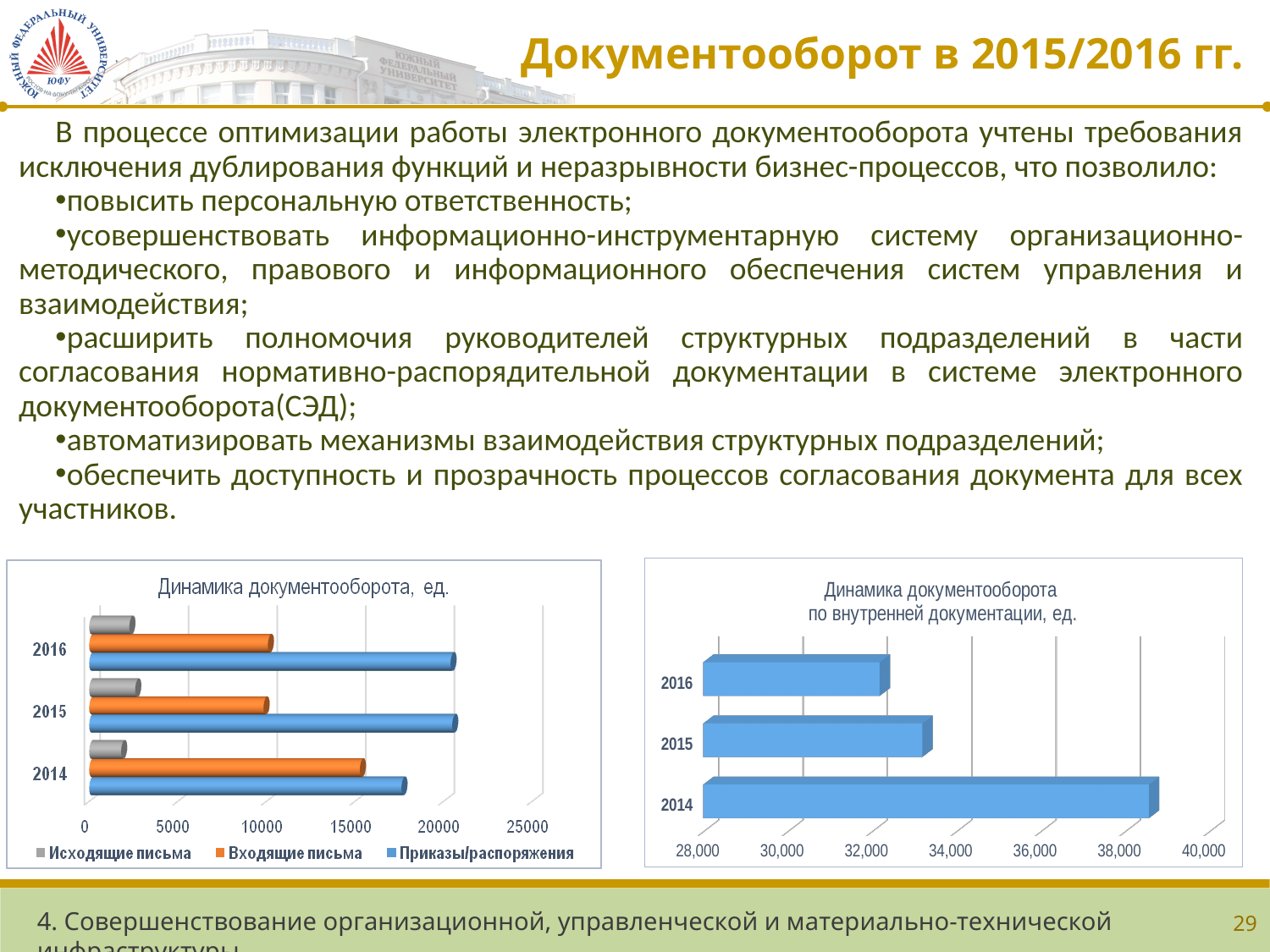
What kind of chart is the left chart titled "Динамика документооборота, ед."? bar chart In the left chart "Динамика документооборота, ед.", is the value for Приказы/распоряжения in 2016 greater or less than 20000? greater What is the title of the right chart on the slide? Динамика документооборота по внутренней документации, ед. In the left chart "Динамика документооборота, ед.", which series has the shortest bar for 2014? Исходящие письма In the left chart "Динамика документооборота, ед.", which year has the larger value for Входящие письма, 2014 or 2016? 2014 In the right chart "Динамика документооборота по внутренней документации, ед.", do the values rise or fall from 2014 to 2016? fall How many years are shown on the right chart "Динамика документооборота по внутренней документации, ед."? 3 How many series does the legend of the left chart "Динамика документооборота, ед." list? 3 In the right chart "Динамика документооборота по внутренней документации, ед.", is the value for 2014 greater or less than 38,000? greater In the right chart "Динамика документооборота по внутренней документации, ед.", which year has the highest value? 2014 In the left chart "Динамика документооборота, ед.", which series has the longest bar for 2016? Приказы/распоряжения